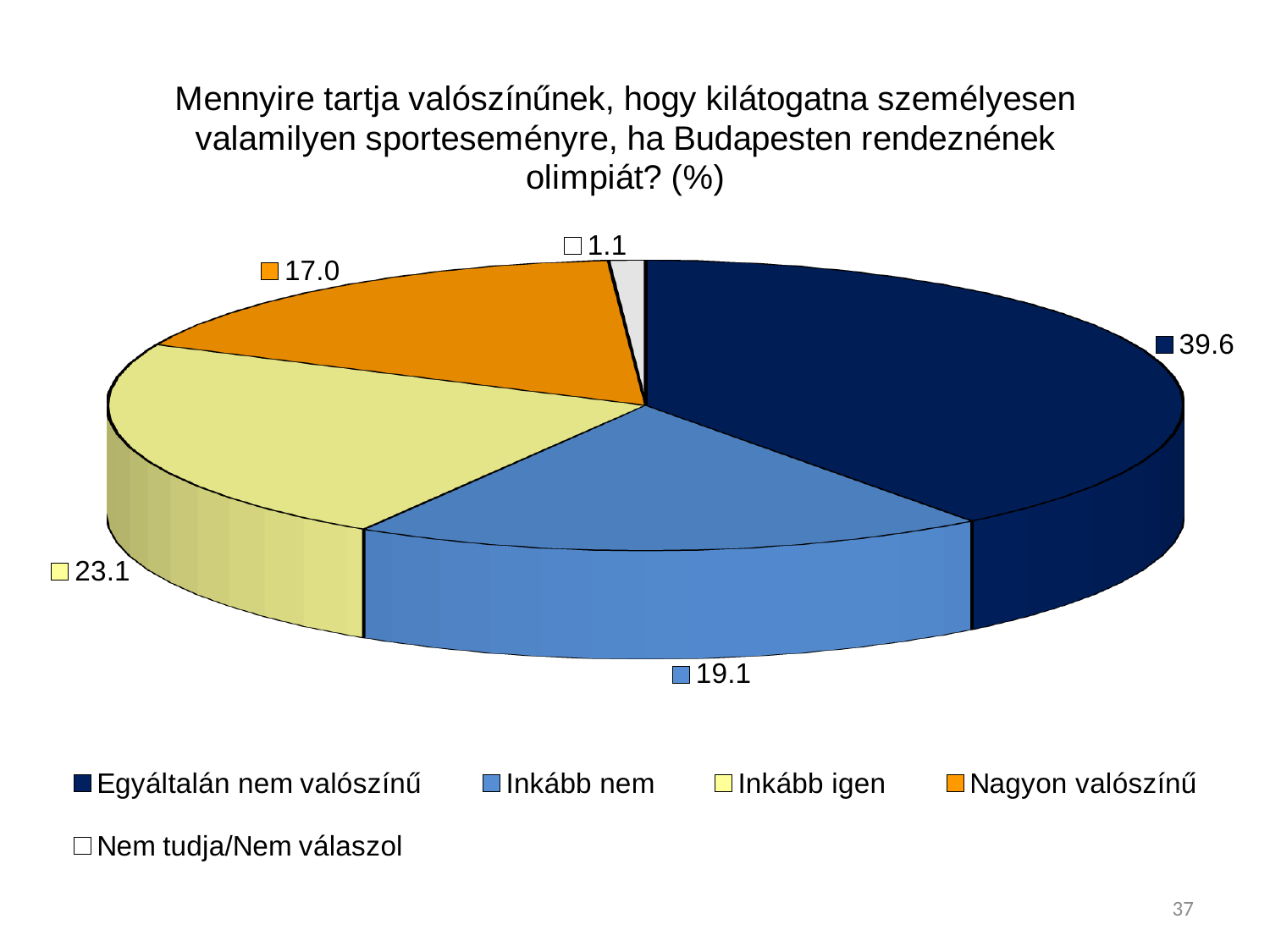
What is the value for "Nem tudja/Nem válaszol"? 1.1 What kind of chart is shown on the slide? pie chart How many categories does the legend list? 5 Which colour represents "Nagyon valószínű" in the chart? orange Which category has the smallest slice? Nem tudja/Nem válaszol Which is larger, the value for "Inkább igen" or the value for "Inkább nem"? Inkább igen What is the value for "Inkább nem"? 19.1 Which category has the largest slice? Egyáltalán nem valószínű What is the value for "Egyáltalán nem valószínű"? 39.6 What is the value for "Inkább igen"? 23.1 What is the value for "Nagyon valószínű"? 17.0 What is the difference between the values for "Egyáltalán nem valószínű" and "Inkább igen"? 16.5